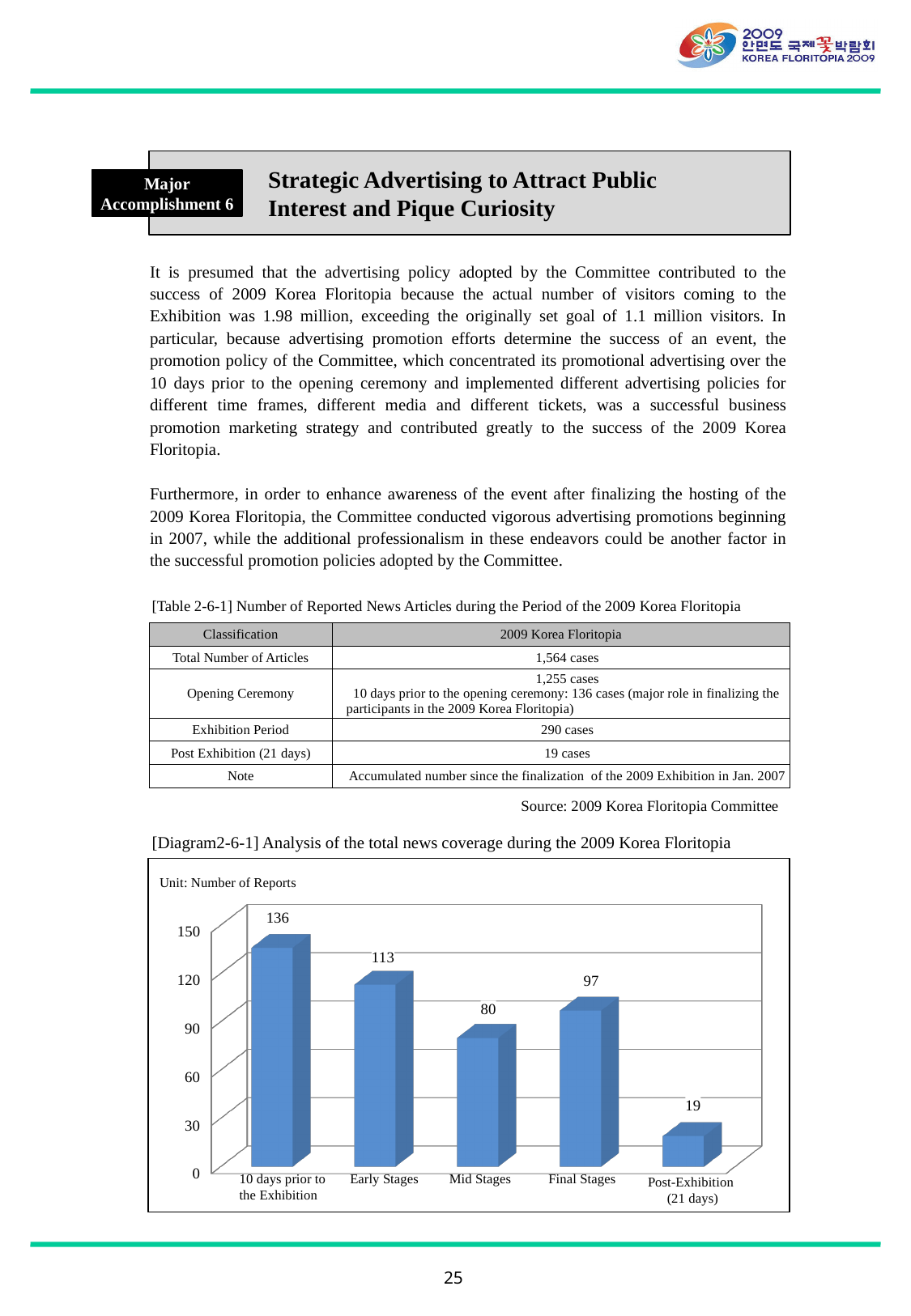
What is the title of the diagram? Analysis of the total news coverage during the 2009 Korea Floritopia What kind of chart is the diagram? bar chart Is the value for 'Early Stages' greater or less than 90? greater What is the number of reports for '10 days prior to the Exhibition' in the diagram? 136 Which has more reports, 'Final Stages' or 'Mid Stages'? Final Stages How many categories are shown in the diagram? 5 Which category has the lowest number of reports in the diagram? Post-Exhibition (21 days) What is the number of reports for 'Post-Exhibition (21 days)' in the diagram? 19 What is the number of reports for 'Mid Stages' in the diagram? 80 Which category has the highest number of reports in the diagram? 10 days prior to the Exhibition What unit is stated for the values in the diagram? Number of Reports What is the difference in number of reports between 'Early Stages' and 'Final Stages'? 16